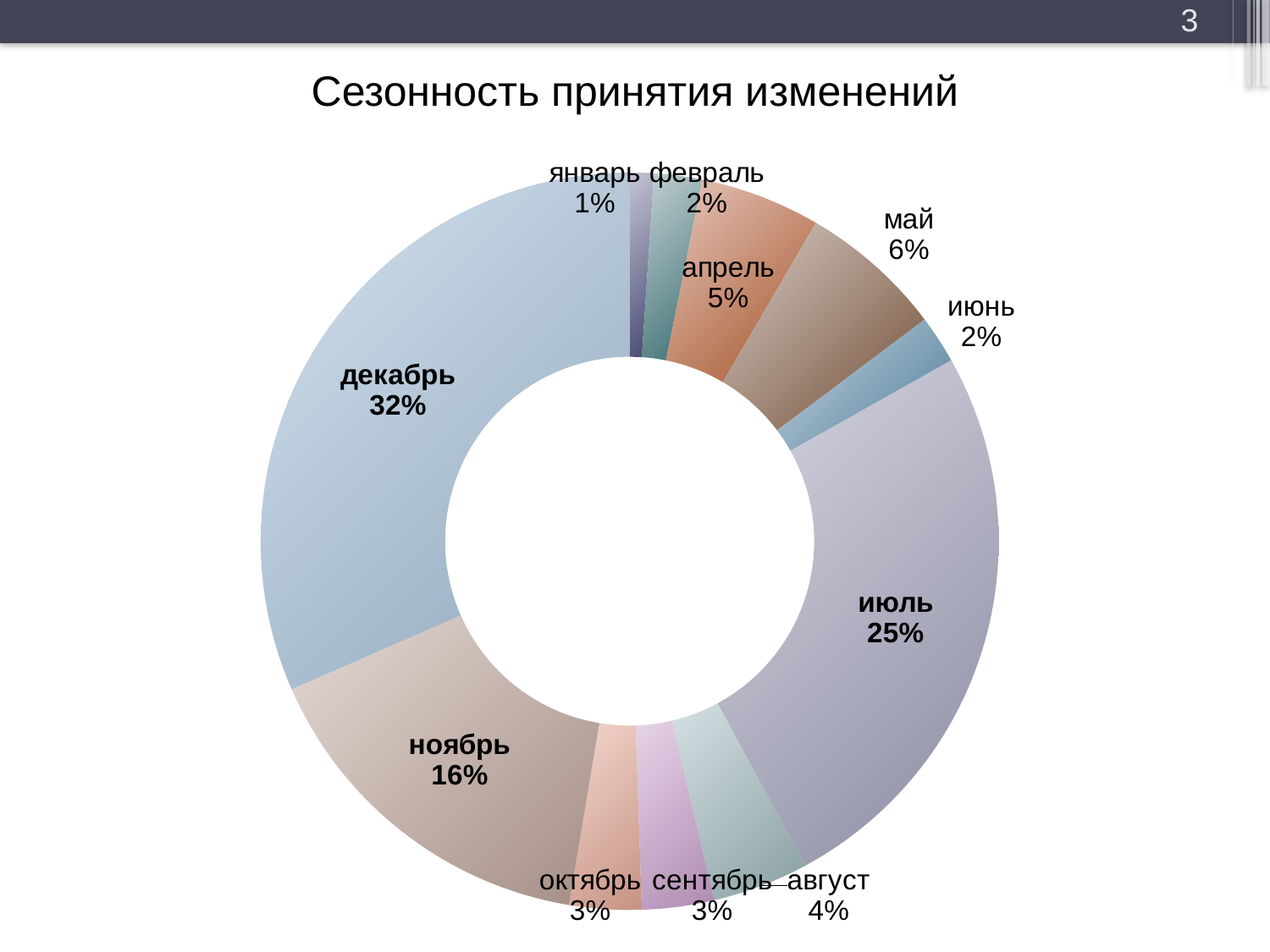
What share of the chart does декабрь account for? 32% Which month has the largest share in the chart? декабрь What is the combined share of ноябрь and декабрь? 48% What percentage is shown for май? 6% Which month has the smallest share in the chart? январь What is the title of the chart? Сезонность принятия изменений What is the difference between the shares of декабрь and июль? 7% What kind of chart is shown on the slide? doughnut chart How many months (slices) are shown in the chart? 11 What is the value for ноябрь? 16% Which is larger, the share for ноябрь or the share for июль? июль What is the value shown for июль? 25%